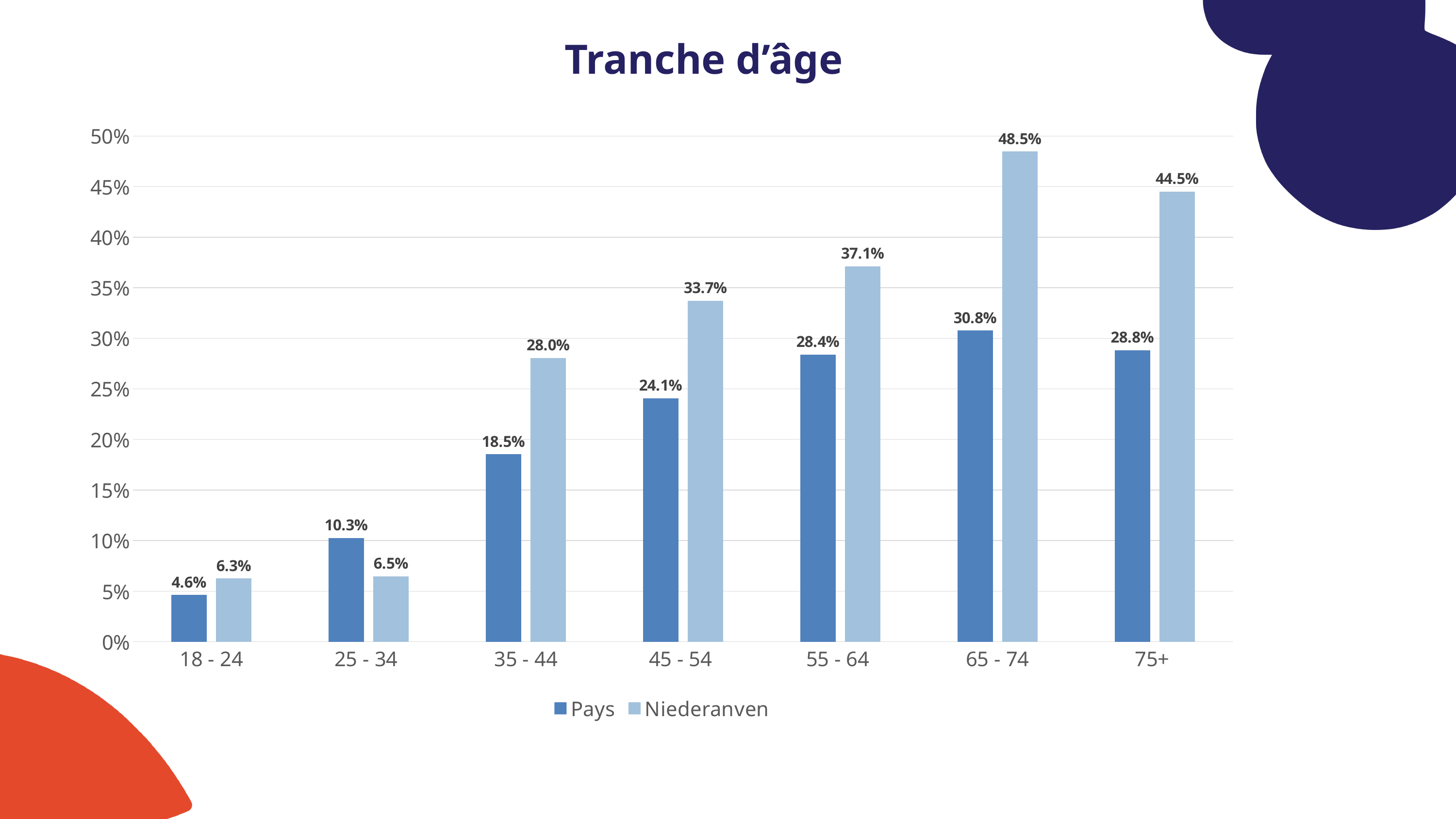
How many age groups are shown on the x axis? 7 Which age group has the highest value for Niederanven? 65 - 74 Is the value for Niederanven in the 55 - 64 age group greater or less than 35%? greater What is the value for Niederanven in the 65 - 74 age group? 48.5% How many series does the legend list? 2 What is the value for Pays in the 75+ age group? 28.8% Which age group has the lowest value for Pays? 18 - 24 Which is larger in the 25 - 34 age group, Pays or Niederanven? Pays What is the difference between Niederanven and Pays in the 45 - 54 age group? 9.6% What is the value for Pays in the 18 - 24 age group? 4.6% What kind of chart is shown on the slide? Bar chart What is the title of the chart? Tranche d’âge